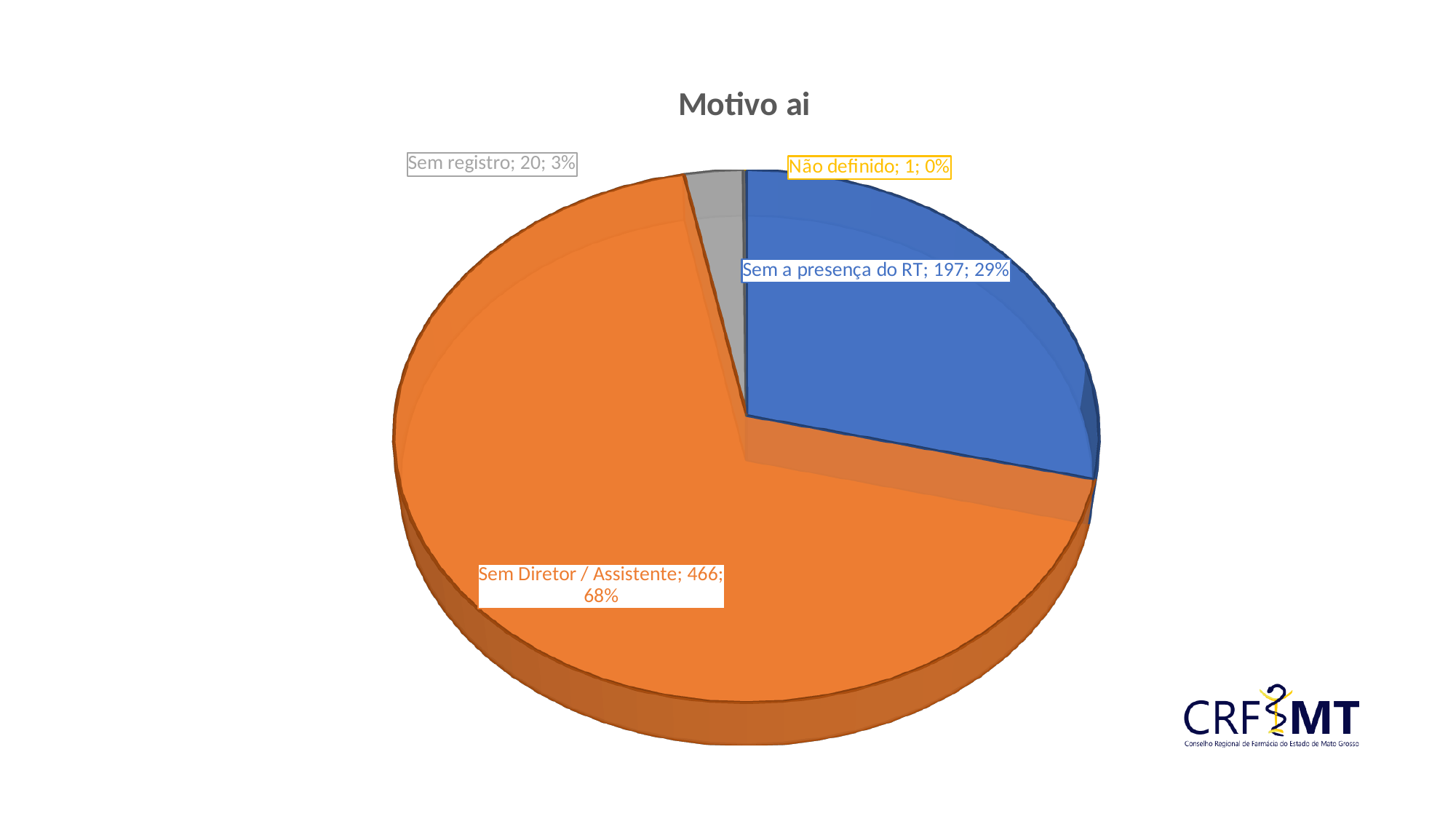
What is the value for Sem Diretor / Assistente? 466 What is the difference between the values for Sem Diretor / Assistente and Sem a presença do RT? 269 What is the value for Não definido? 1 Which category has the largest slice? Sem Diretor / Assistente Which is larger, the value for Sem registro or the value for Não definido? Sem registro Which category has the smallest slice? Não definido What is the value for Sem a presença do RT? 197 What share of the pie does Sem a presença do RT represent? 29% What is the value for Sem registro? 20 What is the title of the chart? Motivo ai How many slices does the pie chart have? 4 What kind of chart is shown on the slide? Pie chart